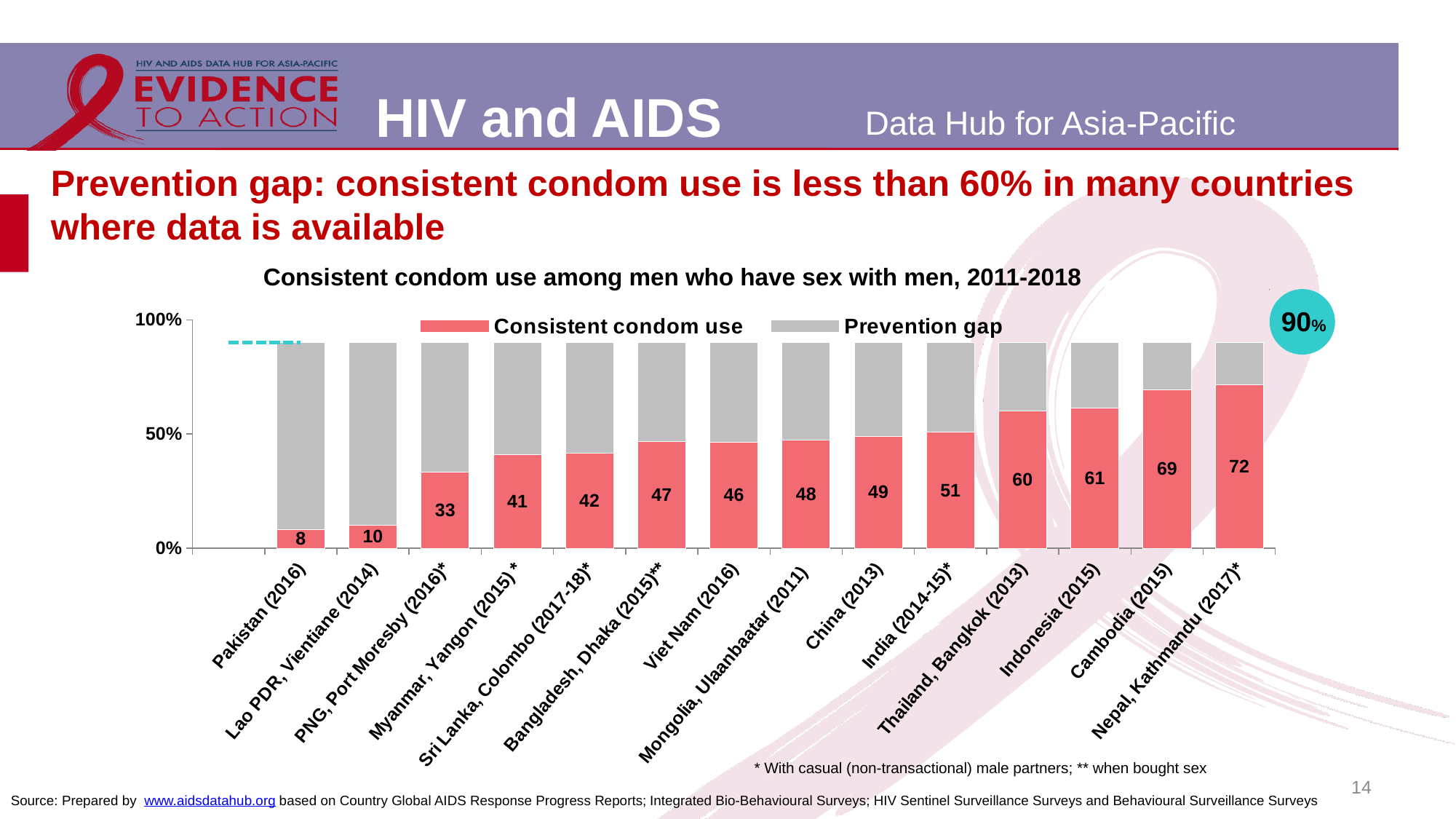
Which has a higher consistent condom use value, China (2013) or Myanmar, Yangon (2015)*? China (2013) What type of chart is used to show consistent condom use among men who have sex with men? Stacked bar chart What is the difference in consistent condom use between Cambodia (2015) and Indonesia (2015)? 8 Is the consistent condom use value for India (2014-15)* greater or less than 50%? greater What is the difference in consistent condom use between Lao PDR, Vientiane (2014) and Pakistan (2016)? 2 Which country has the lowest consistent condom use value? Pakistan (2016) What is the consistent condom use value for Thailand, Bangkok (2013)? 60 What is the consistent condom use value for Viet Nam (2016)? 46 What is the consistent condom use value for PNG, Port Moresby (2016)*? 33 How many countries or cities are shown on the x axis of the chart? 14 Which country has the highest consistent condom use value? Nepal, Kathmandu (2017)* How many series does the chart legend list? 2